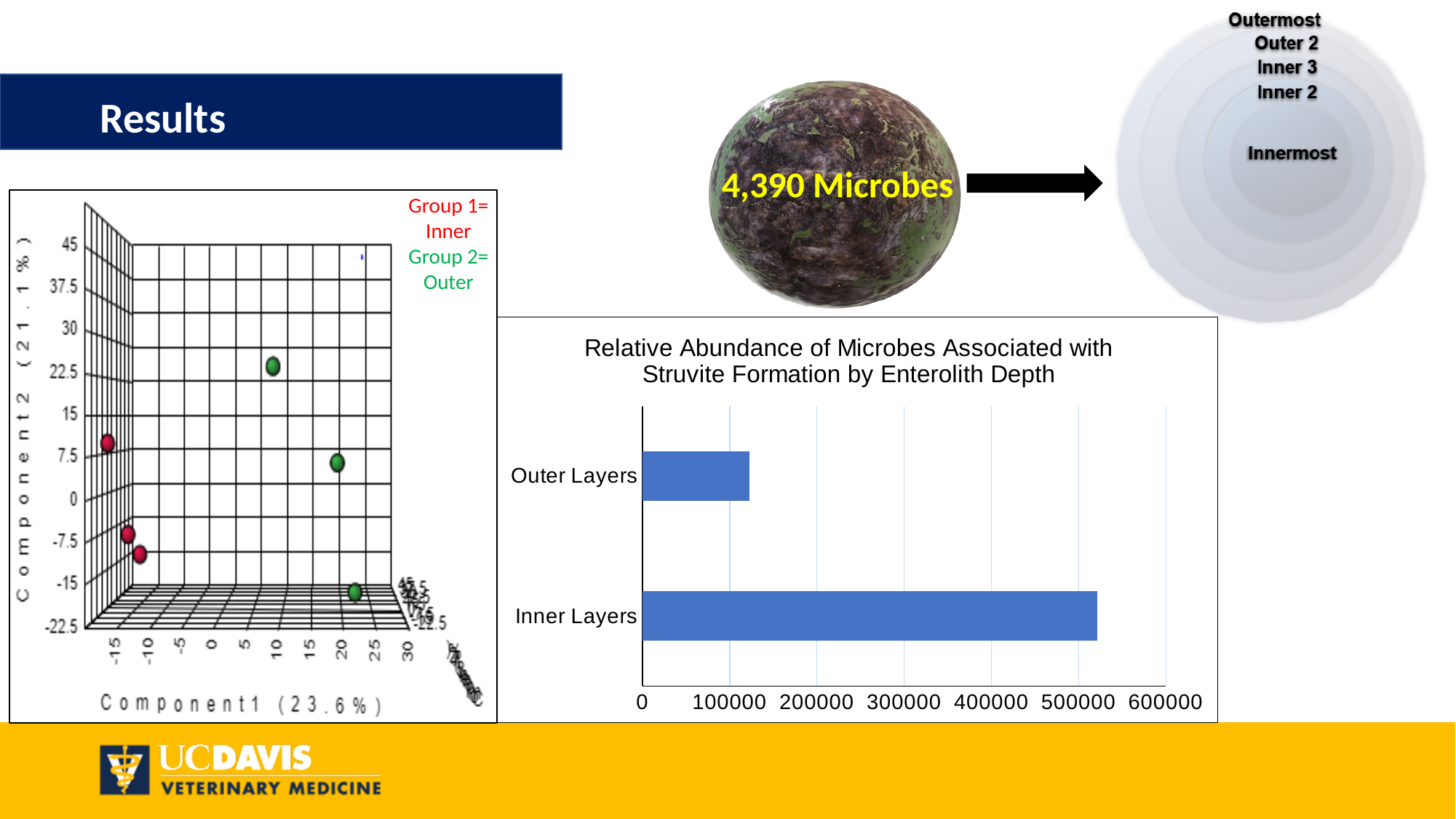
In the 'Relative Abundance of Microbes Associated with Struvite Formation by Enterolith Depth' chart, which category has the lowest value? Outer Layers In the 'Relative Abundance of Microbes Associated with Struvite Formation by Enterolith Depth' chart, which category has the highest value? Inner Layers What kind of chart is the 'Relative Abundance of Microbes Associated with Struvite Formation by Enterolith Depth' chart? bar chart In the scatter plot on the left of the slide, what percentage of variance is explained by Component 1, as shown in the x-axis label? 23.6% In the 'Relative Abundance of Microbes Associated with Struvite Formation by Enterolith Depth' chart, what is the maximum value shown on the horizontal axis? 600000 In the 'Relative Abundance of Microbes Associated with Struvite Formation by Enterolith Depth' chart, is the value for Outer Layers greater or less than 100000? greater In the scatter plot on the left of the slide, what does Group 1 (red) represent according to the legend? Inner In the 'Relative Abundance of Microbes Associated with Struvite Formation by Enterolith Depth' chart, how many categories are plotted? 2 In the 'Relative Abundance of Microbes Associated with Struvite Formation by Enterolith Depth' chart, is the value for Inner Layers greater or less than 500000? greater In the 'Relative Abundance of Microbes Associated with Struvite Formation by Enterolith Depth' chart, which is larger, the value for Inner Layers or Outer Layers? Inner Layers In the scatter plot on the left of the slide, what percentage of variance is explained by Component 2, as shown in the y-axis label? 21.1% In the 'Relative Abundance of Microbes Associated with Struvite Formation by Enterolith Depth' chart, is the value for Outer Layers greater or less than 200000? less